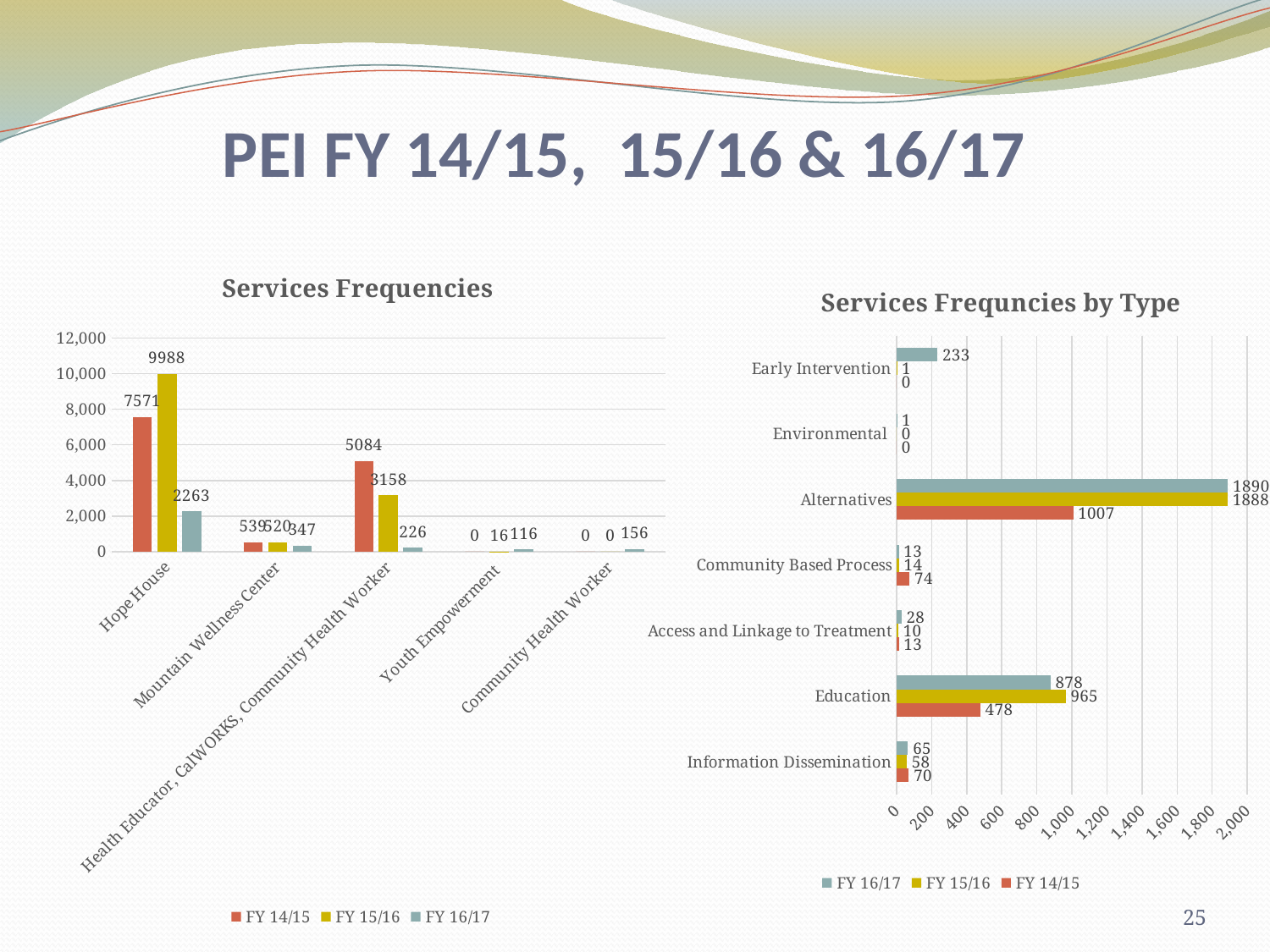
In the Services Frequncies by Type chart, which is larger for Education: the FY 15/16 value or the FY 16/17 value? FY 15/16 In the Services Frequencies chart, what kind of chart is used? Bar chart In the Services Frequncies by Type chart, what is the difference between the FY 15/16 and FY 14/15 values for Education? 487 In the Services Frequncies by Type chart, which category has the highest FY 16/17 value? Alternatives In the Services Frequencies chart, what is the FY 14/15 value for Health Educator, CalWORKS, Community Health Worker? 5084 In the Services Frequencies chart, what is the difference between the FY 15/16 and FY 14/15 values for Hope House? 2417 In the Services Frequencies chart, what is the FY 15/16 value for Hope House? 9988 In the Services Frequncies by Type chart, how many series does the legend list? 3 In the Services Frequencies chart, which category has the highest FY 14/15 value? Hope House In the Services Frequncies by Type chart, what is the FY 16/17 value for Early Intervention? 233 In the Services Frequencies chart, how many categories are shown on the x axis? 5 In the Services Frequncies by Type chart, what is the FY 14/15 value for Alternatives? 1007